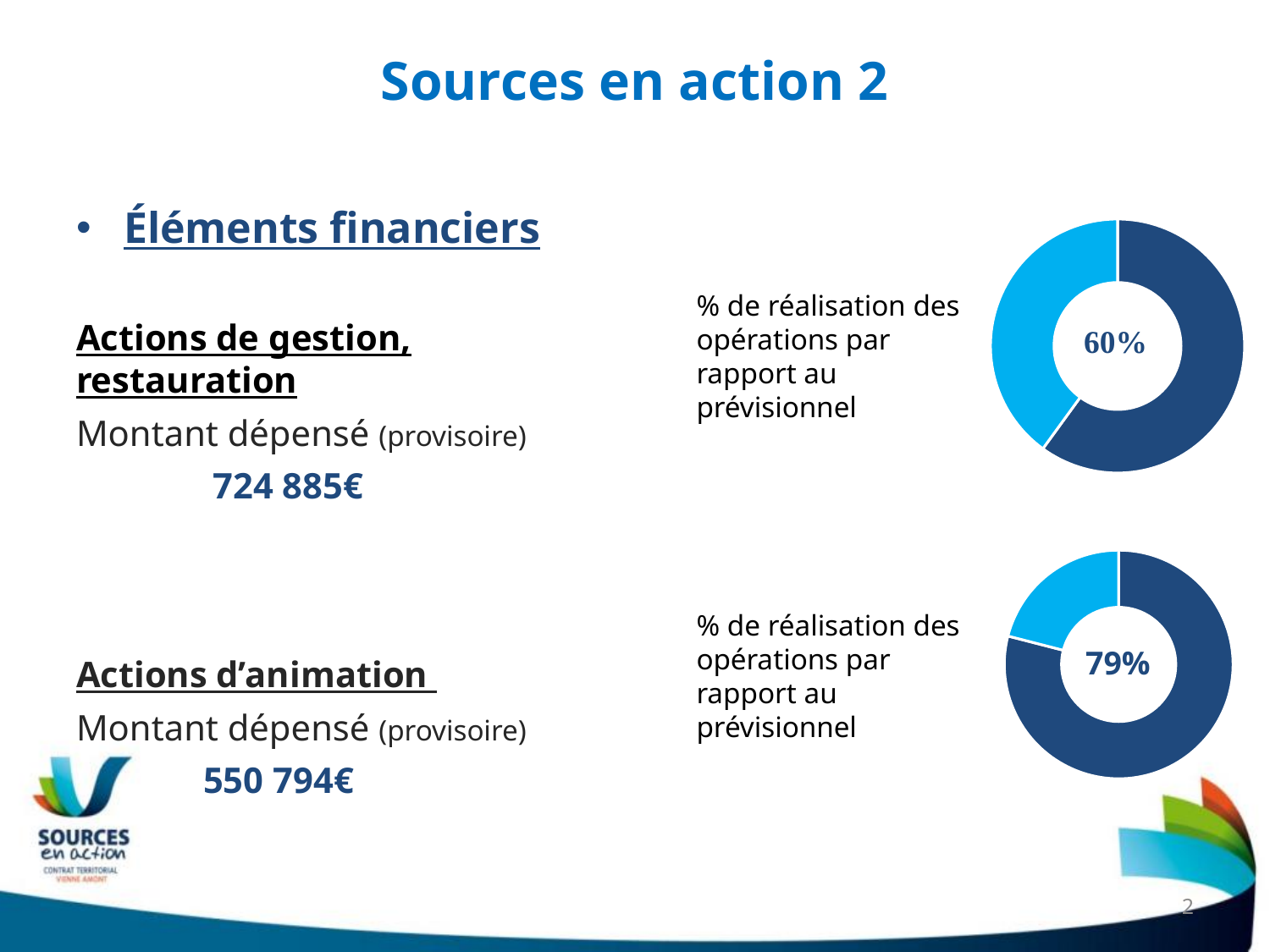
How many slices does the top chart (Actions de gestion, restauration) have? 2 In the bottom chart (Actions d'animation), what percentage of realisation is shown? 79% How many donut charts are shown on the slide? 2 What colour is the larger slice in the bottom chart (Actions d'animation)? dark blue In the top chart (Actions de gestion, restauration), what percentage of realisation is shown? 60% Which section shows the higher % de réalisation des opérations par rapport au prévisionnel: Actions de gestion, restauration or Actions d'animation? Actions d'animation In the top chart, which slice is larger: the dark blue one or the light blue one? dark blue What kind of chart is used to show the % de réalisation des opérations on this slide? pie chart (donut) What is the difference between the realisation percentage in the bottom chart (79%) and the top chart (60%)? 19 percentage points In the top chart, is the realisation percentage greater or less than 50%? greater What do the two donut charts on the slide represent, according to the text next to them? % de réalisation des opérations par rapport au prévisionnel In the bottom chart, what share of the donut does the dark blue slice represent? 79%